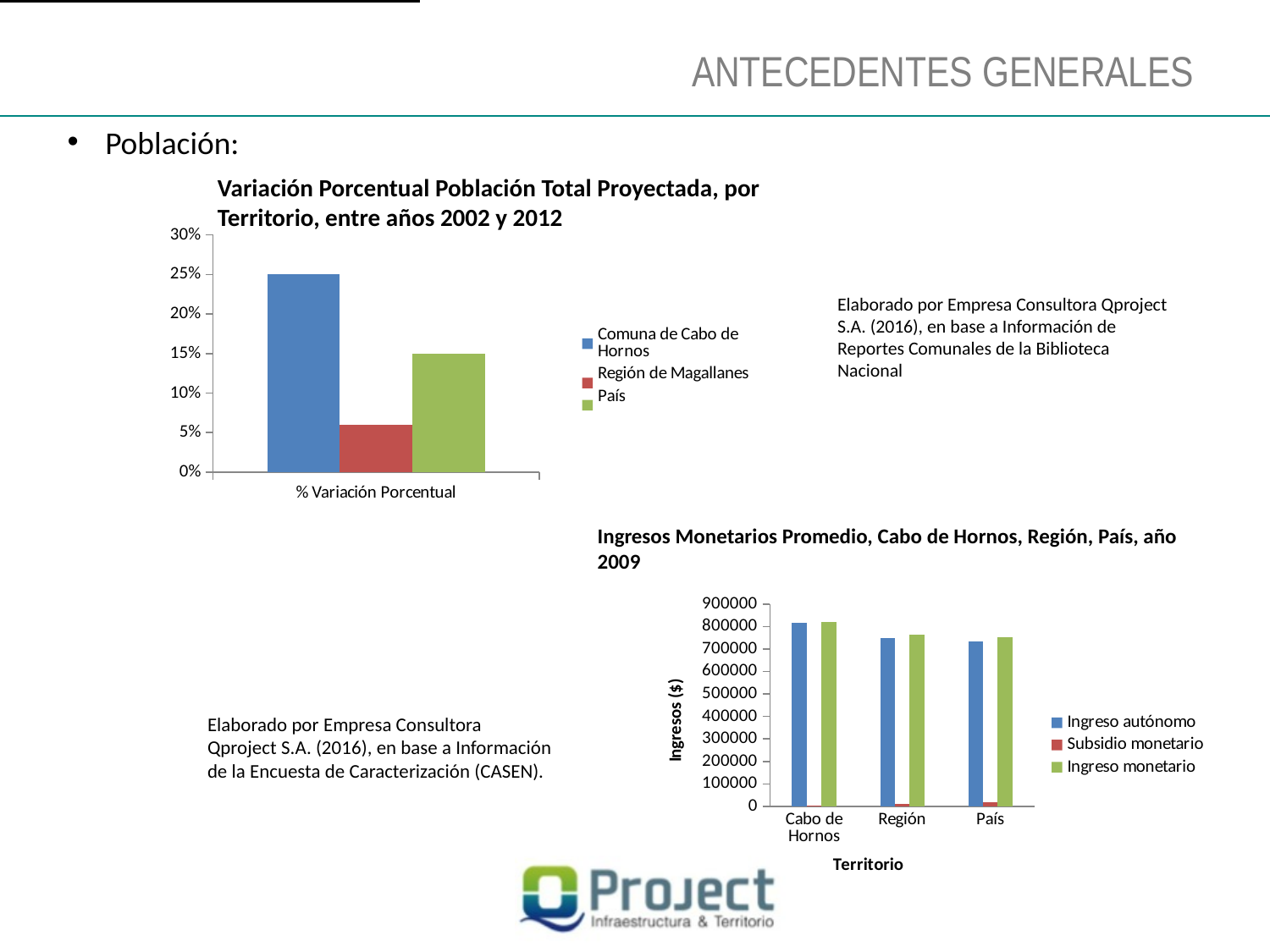
In the chart 'Ingresos Monetarios Promedio, Cabo de Hornos, Región, País, año 2009', which is larger: the Ingreso autónomo for Cabo de Hornos or for País? Cabo de Hornos In the chart 'Variación Porcentual Población Total Proyectada, por Territorio, entre años 2002 y 2012', which territory has the lowest percentage variation? Región de Magallanes In the chart 'Variación Porcentual Población Total Proyectada, por Territorio, entre años 2002 y 2012', is the value for Comuna de Cabo de Hornos greater or less than 20%? greater In the chart 'Ingresos Monetarios Promedio, Cabo de Hornos, Región, País, año 2009', how many territories are shown on the x axis? 3 What kind of chart is 'Variación Porcentual Población Total Proyectada, por Territorio, entre años 2002 y 2012'? bar chart In the chart 'Ingresos Monetarios Promedio, Cabo de Hornos, Región, País, año 2009', which territory has the highest Ingreso monetario? Cabo de Hornos In the chart 'Ingresos Monetarios Promedio, Cabo de Hornos, Región, País, año 2009', is the Ingreso autónomo for Región greater or less than 800000? less In the chart 'Variación Porcentual Población Total Proyectada, por Territorio, entre años 2002 y 2012', how many series does the legend list? 3 In the chart 'Variación Porcentual Población Total Proyectada, por Territorio, entre años 2002 y 2012', is the value for Región de Magallanes greater or less than 10%? less In the chart 'Variación Porcentual Población Total Proyectada, por Territorio, entre años 2002 y 2012', which territory has the highest percentage variation? Comuna de Cabo de Hornos In the chart 'Ingresos Monetarios Promedio, Cabo de Hornos, Región, País, año 2009', what is the label of the y axis? Ingresos ($)